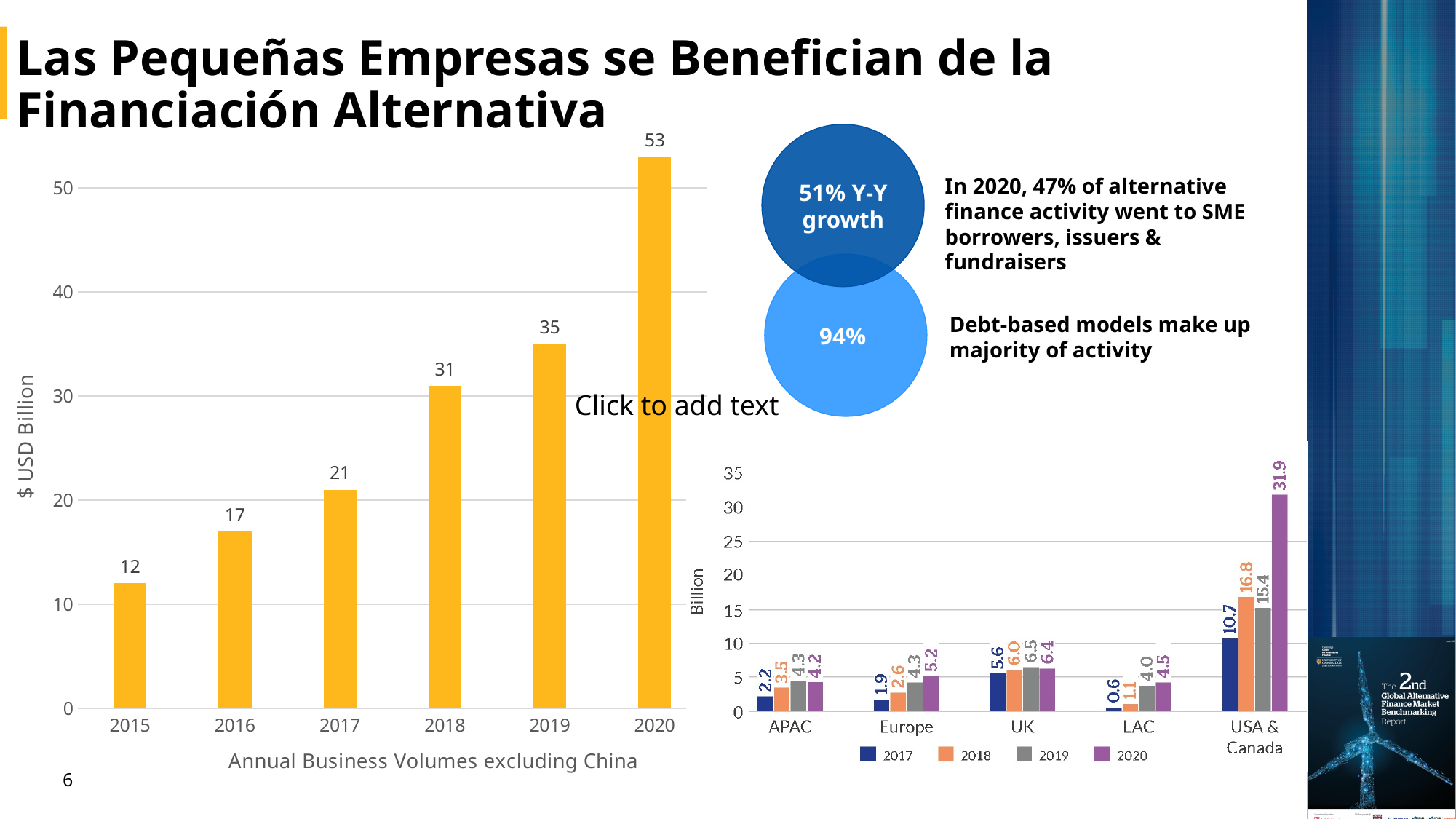
In the right regional chart, what is the value for USA & Canada in 2020? 31.9 What kind of chart is the left chart 'Annual Business Volumes excluding China'? bar chart In the left chart 'Annual Business Volumes excluding China', what is the difference between the 2020 and 2019 values? 18 In the left chart 'Annual Business Volumes excluding China', do the values rise or fall from 2015 to 2020? rise In the right regional chart, what is the difference between the 2018 and 2017 values for USA & Canada? 6.1 In the right regional chart, which is larger for Europe: the 2019 value or the 2020 value? 2020 In the right regional chart, which region has the highest value in 2020? USA & Canada In the left chart 'Annual Business Volumes excluding China', what is the value for 2020? 53 How many series does the legend of the right regional chart list? 4 In the right regional chart, what is the value for LAC in 2017? 0.6 How many years are shown in the left chart 'Annual Business Volumes excluding China'? 6 In the left chart 'Annual Business Volumes excluding China', which year has the lowest value? 2015